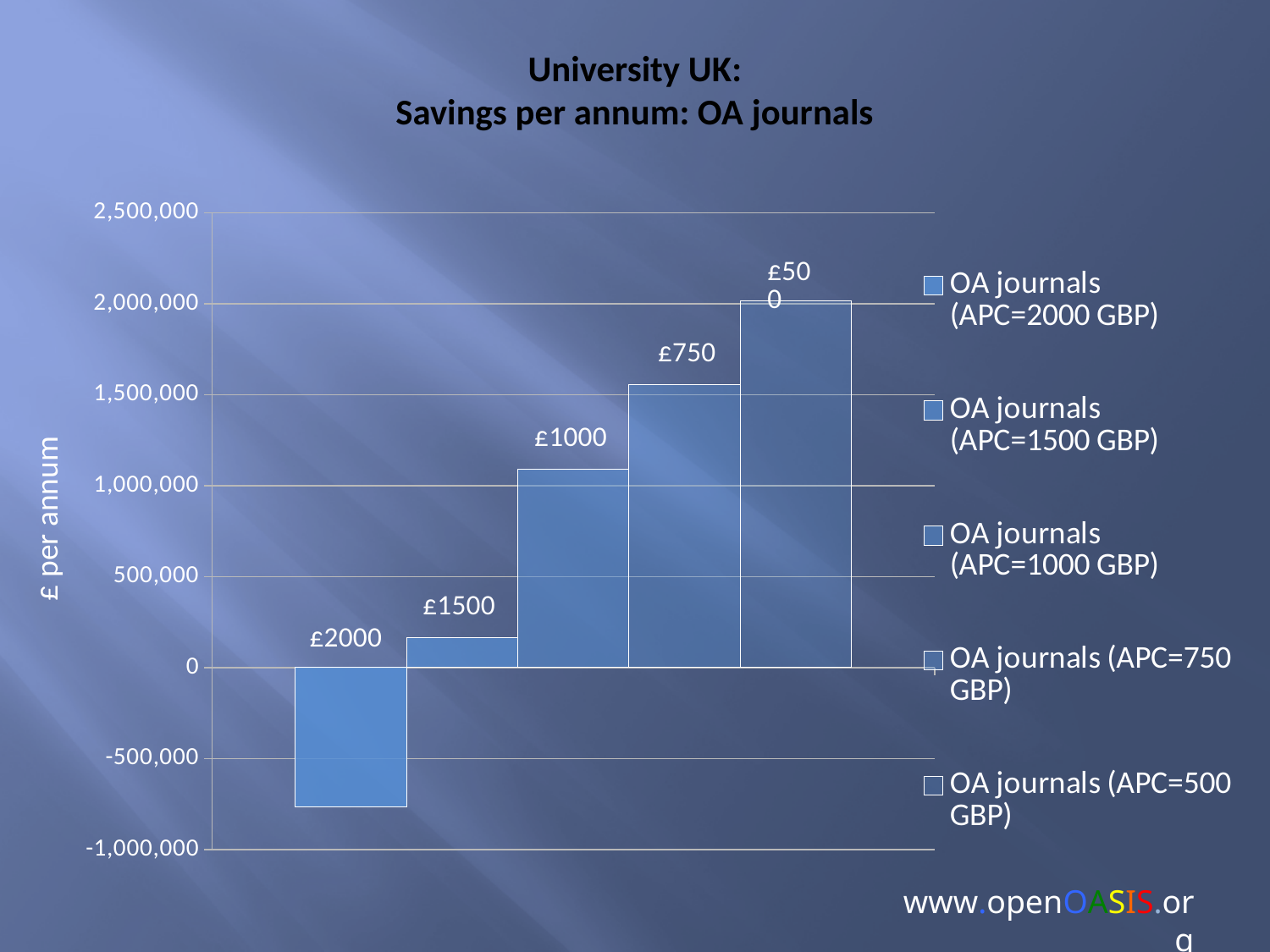
What kind of chart is shown on the slide? bar chart What is the label on the vertical axis of the chart? £ per annum Which is larger: the savings for OA journals (APC=1000 GBP) or for OA journals (APC=1500 GBP)? OA journals (APC=1000 GBP) Is the value for OA journals (APC=1500 GBP) greater or less than 500,000? less Which APC level shows the lowest savings per annum? OA journals (APC=2000 GBP) How many bars are plotted in the chart? 5 Do the savings rise or fall as the APC decreases from £2000 to £500 along the x axis? rise How many series does the legend list? 5 Which APC level shows the highest savings per annum? OA journals (APC=500 GBP) Is the value for OA journals (APC=1000 GBP) greater or less than 1,000,000? greater Is the value for OA journals (APC=750 GBP) greater or less than 1,500,000? greater